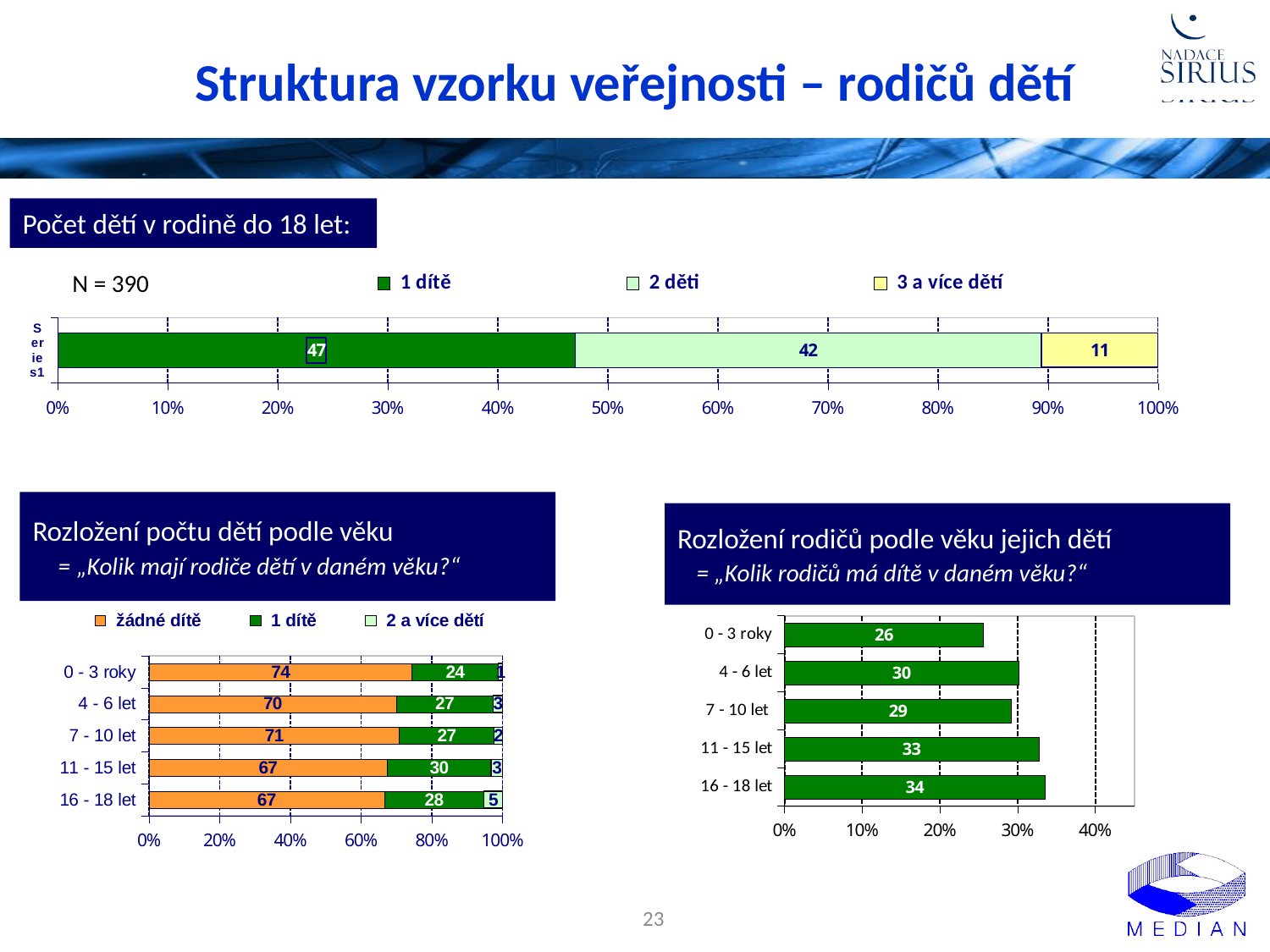
In the bottom-right chart 'Rozložení rodičů podle věku jejich dětí', what is the value for '7 - 10 let'? 29 In the top chart 'Počet dětí v rodině do 18 let', what is the difference between the values for '1 dítě' and '2 děti'? 5 In the bottom-left chart 'Rozložení počtu dětí podle věku', what is the value for 'žádné dítě' in the '0 - 3 roky' category? 74 In the bottom-left chart 'Rozložení počtu dětí podle věku', how many age categories are shown? 5 In the top chart 'Počet dětí v rodině do 18 let', how many series does the legend list? 3 What kind of chart is the bottom-right chart 'Rozložení rodičů podle věku jejich dětí'? bar chart In the bottom-left chart 'Rozložení počtu dětí podle věku', what is the value for '1 dítě' in the '11 - 15 let' category? 30 In the top chart 'Počet dětí v rodině do 18 let', what is the value for '3 a více dětí'? 11 In the bottom-right chart 'Rozložení rodičů podle věku jejich dětí', which age category has the lowest value? 0 - 3 roky In the bottom-left chart 'Rozložení počtu dětí podle věku', what is the value for '2 a více dětí' in the '16 - 18 let' category? 5 In the top chart 'Počet dětí v rodině do 18 let', what is the value for '1 dítě'? 47 In the bottom-right chart 'Rozložení rodičů podle věku jejich dětí', which age category has the highest value? 16 - 18 let